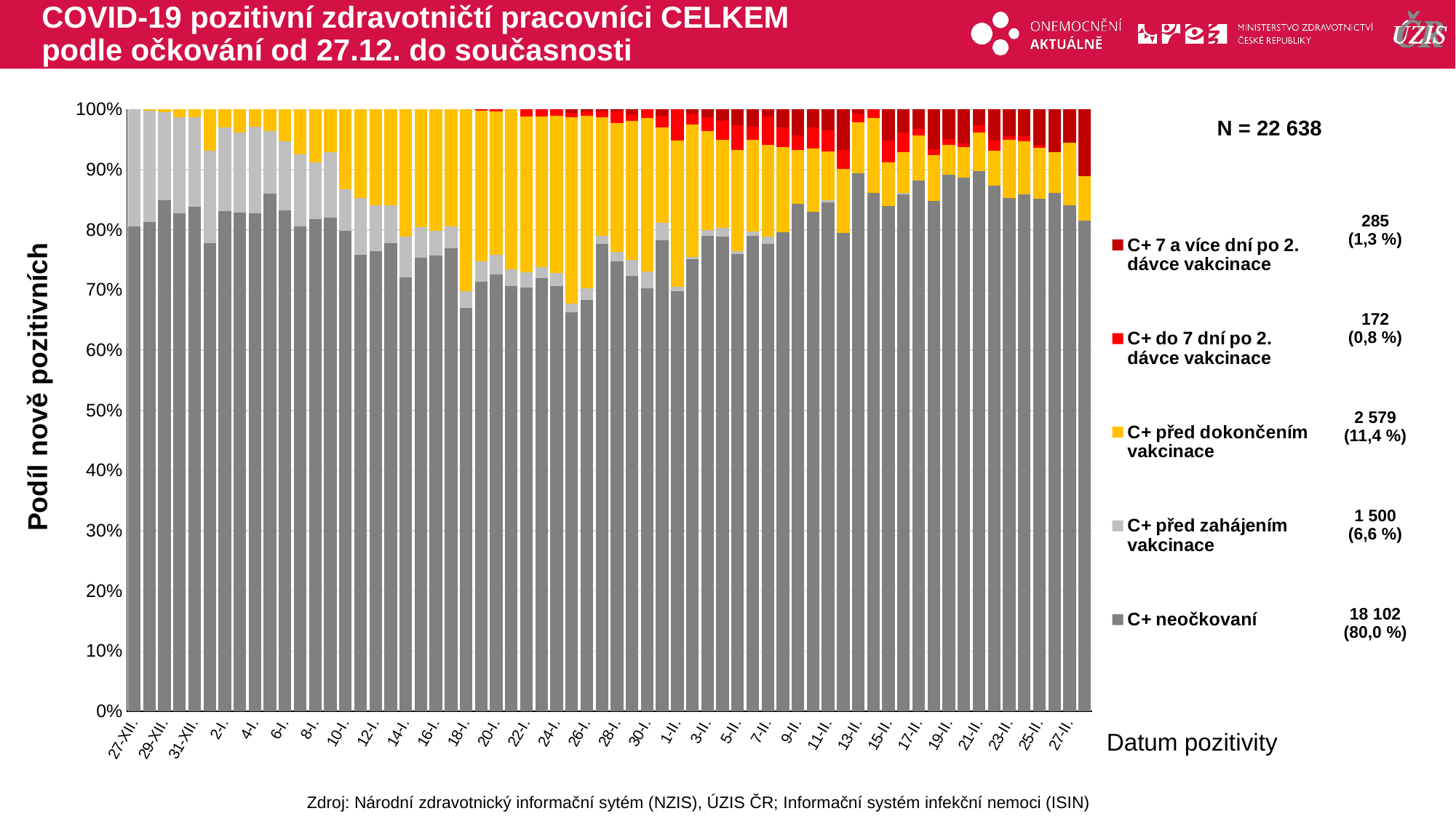
Which legend category has the largest total count? C+ neočkovaní How many series does the legend list? 5 What total count is printed next to the legend entry "C+ neočkovaní"? 18 102 Does the share of "C+ 7 a více dní po 2. dávce vakcinace" rise or fall along the x axis from December to February? rises Which legend category has the smallest total count? C+ do 7 dní po 2. dávce vakcinace What kind of chart is shown on the slide? Stacked bar chart What percentage share is printed next to "C+ před dokončením vakcinace"? 11,4 % What is the title of the x axis? Datum pozitivity What is the difference between the total counts for "C+ před dokončením vakcinace" and "C+ před zahájením vakcinace"? 1 079 Which has the larger total count: "C+ 7 a více dní po 2. dávce vakcinace" or "C+ do 7 dní po 2. dávce vakcinace"? C+ 7 a více dní po 2. dávce vakcinace Is the share of "C+ neočkovaní" on 18-I. greater or less than 70%? less What is the value of N shown on the slide? 22 638